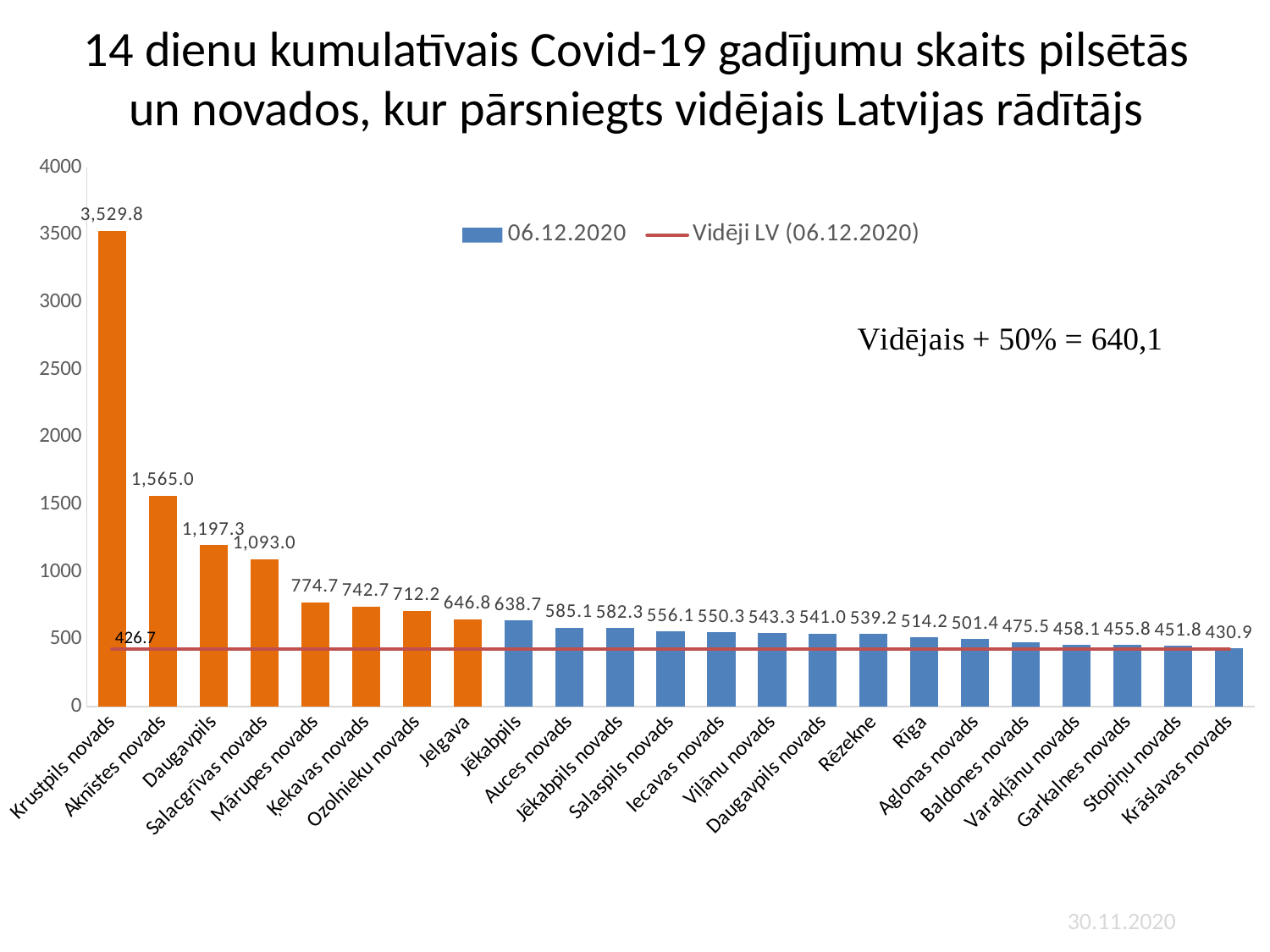
What is the difference between the values for Rīga and Krāslavas novads? 83.3 What kind of chart is this? Combination bar and line chart How many entries does the legend list? 2 What is the value for Jelgava? 646.8 What is the value for Krustpils novads? 3,529.8 What is the value of the Vidēji LV (06.12.2020) line? 426.7 What is the difference between the values for Krustpils novads and Aknīstes novads? 1,964.8 Which category has the highest value? Krustpils novads What is the value for Rīga? 514.2 Which is larger, the value for Daugavpils or the value for Salacgrīvas novads? Daugavpils Which category has the lowest value? Krāslavas novads How many cities and districts are shown on the chart? 23